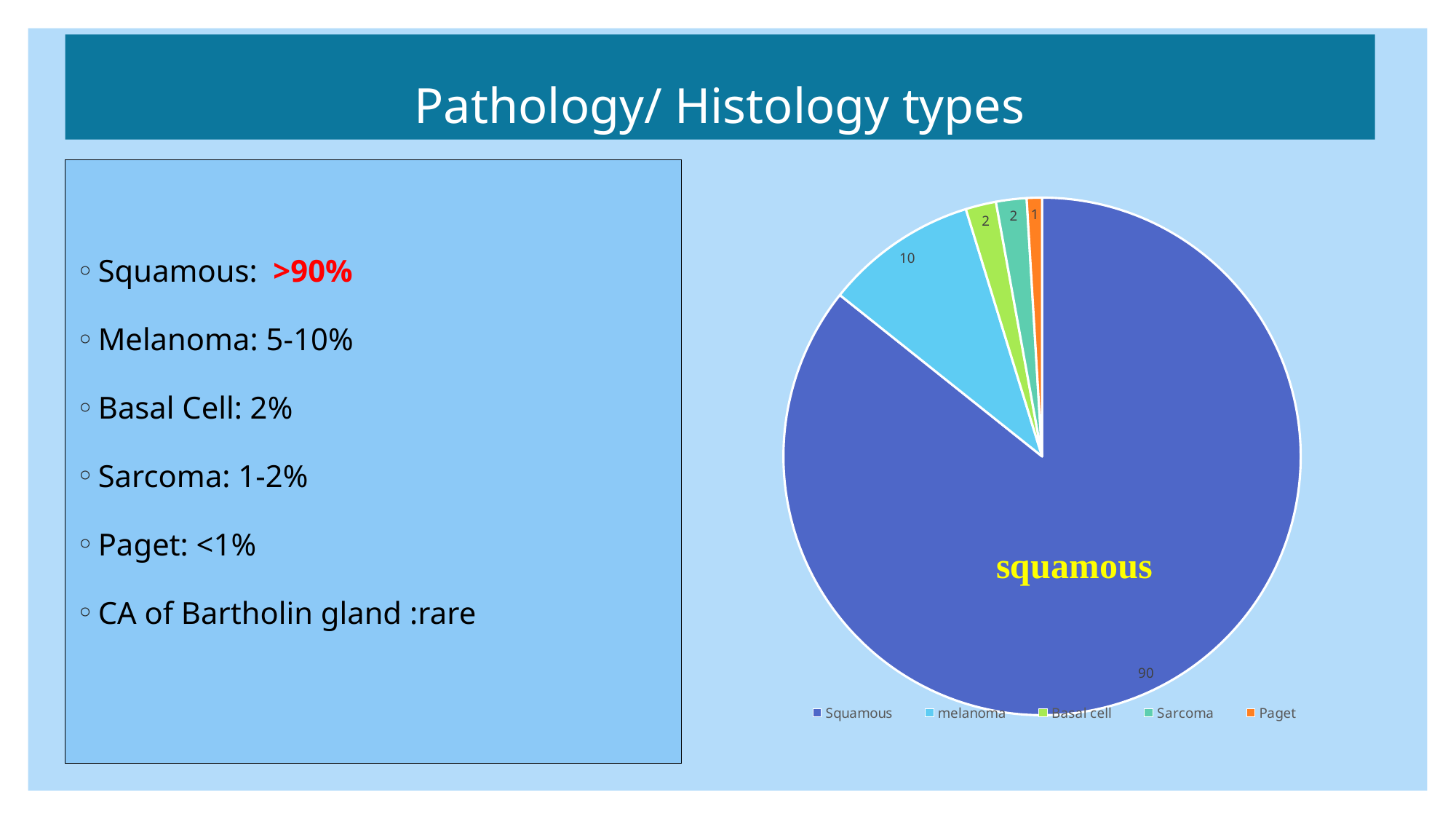
What value is shown for the Basal cell slice of the pie chart? 2 Which category has the largest slice in the pie chart? Squamous What value is shown for the melanoma slice of the pie chart? 10 Which is larger in the pie chart, the melanoma slice or the Basal cell slice? melanoma What kind of chart is shown on the slide? Pie chart What colour is the Paget slice in the pie chart? Orange Which category has the smallest slice in the pie chart? Paget What is the difference between the melanoma value and the Sarcoma value in the pie chart? 8 What value is shown for the Paget slice of the pie chart? 1 What value is shown for the Squamous slice of the pie chart? 90 How many categories are shown in the pie chart? 5 What is the difference between the Squamous value and the melanoma value in the pie chart? 80